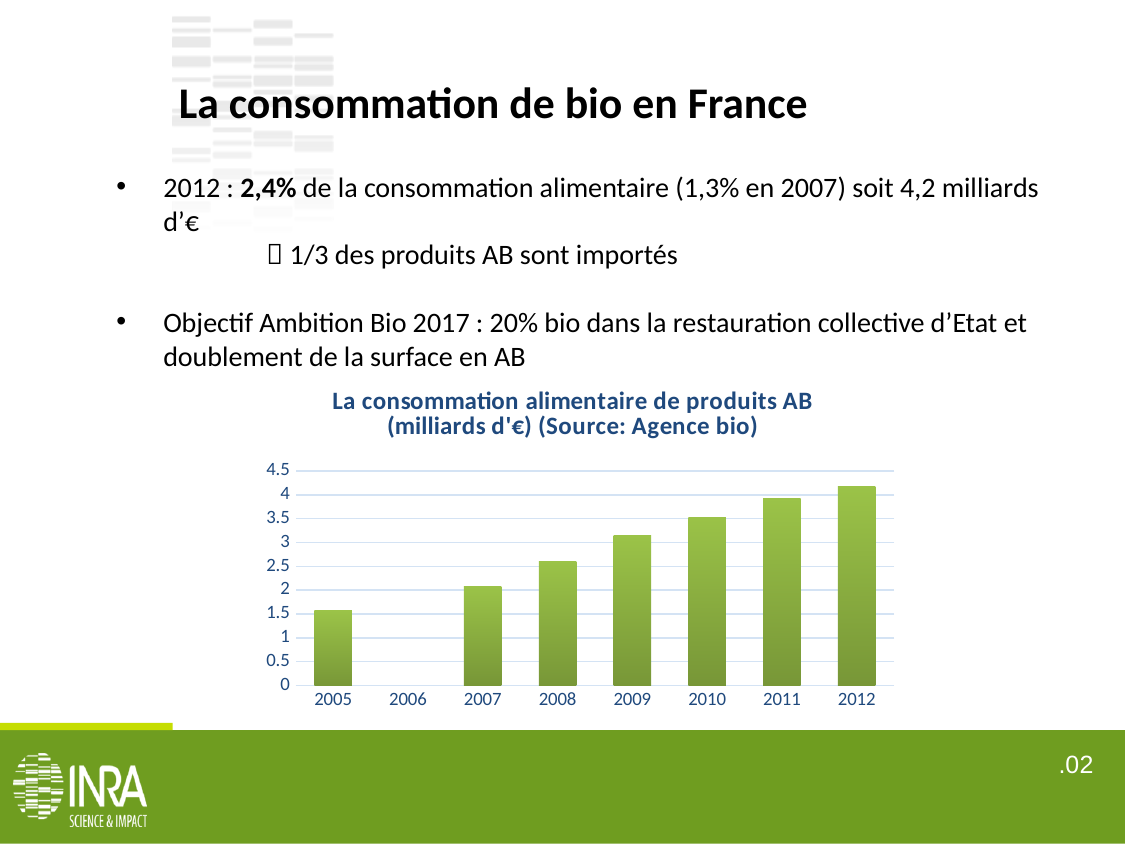
Is the value for 2009 greater or less than 3? greater What is the title of the chart? La consommation alimentaire de produits AB (milliards d'€) (Source: Agence bio) Is the value for 2010 greater or less than 4? less Is the value for 2005 greater or less than 2? less Which is larger, the value for 2008 or the value for 2011? 2011 Which year has the lowest bar in the chart? 2005 What kind of chart is shown on the slide? bar chart Which year has the highest bar in the chart? 2012 Do the values rise or fall from 2005 to 2012? rise How many years are labelled on the x axis of the chart? 8 Which year on the x axis has no bar plotted? 2006